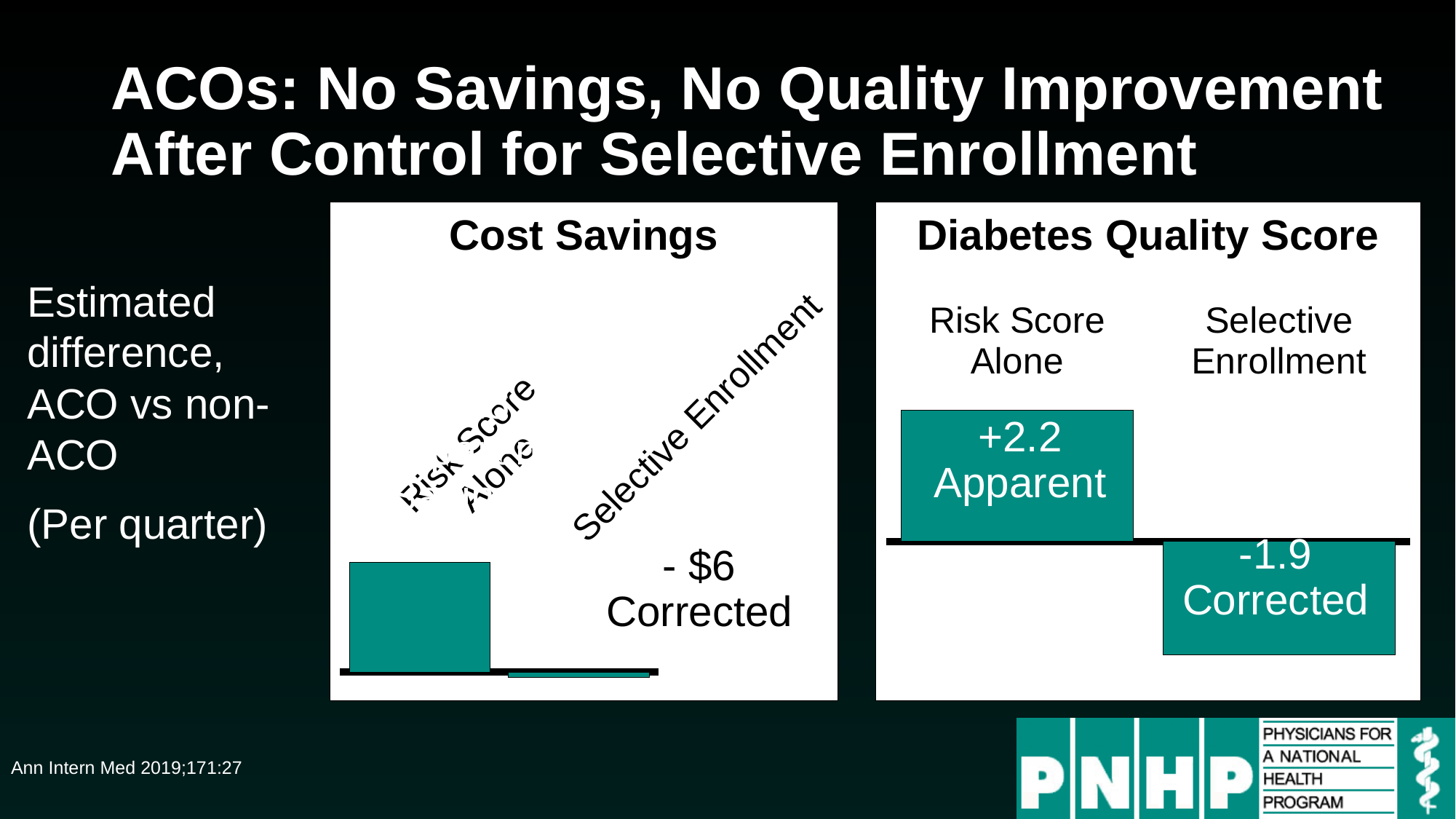
In the Diabetes Quality Score chart, which category has the lowest value? Selective Enrollment In the Diabetes Quality Score chart, what is the value for Risk Score Alone? +2.2 In the Cost Savings chart, which category has the higher bar: Risk Score Alone or Selective Enrollment? Risk Score Alone What is the title of the chart on the right side of the slide? Diabetes Quality Score In the Cost Savings chart, which category has the highest value? Risk Score Alone In the Cost Savings chart, what is the value for Selective Enrollment? - $6 In the Diabetes Quality Score chart, is the Selective Enrollment value positive or negative? Negative In the Diabetes Quality Score chart, what is the value for Selective Enrollment? -1.9 In the Diabetes Quality Score chart, which is larger: Risk Score Alone or Selective Enrollment? Risk Score Alone In the Diabetes Quality Score chart, what is the difference between the Risk Score Alone value and the Selective Enrollment value? 4.1 What kind of chart is the Cost Savings chart? Bar chart How many categories are shown in the Diabetes Quality Score chart? 2